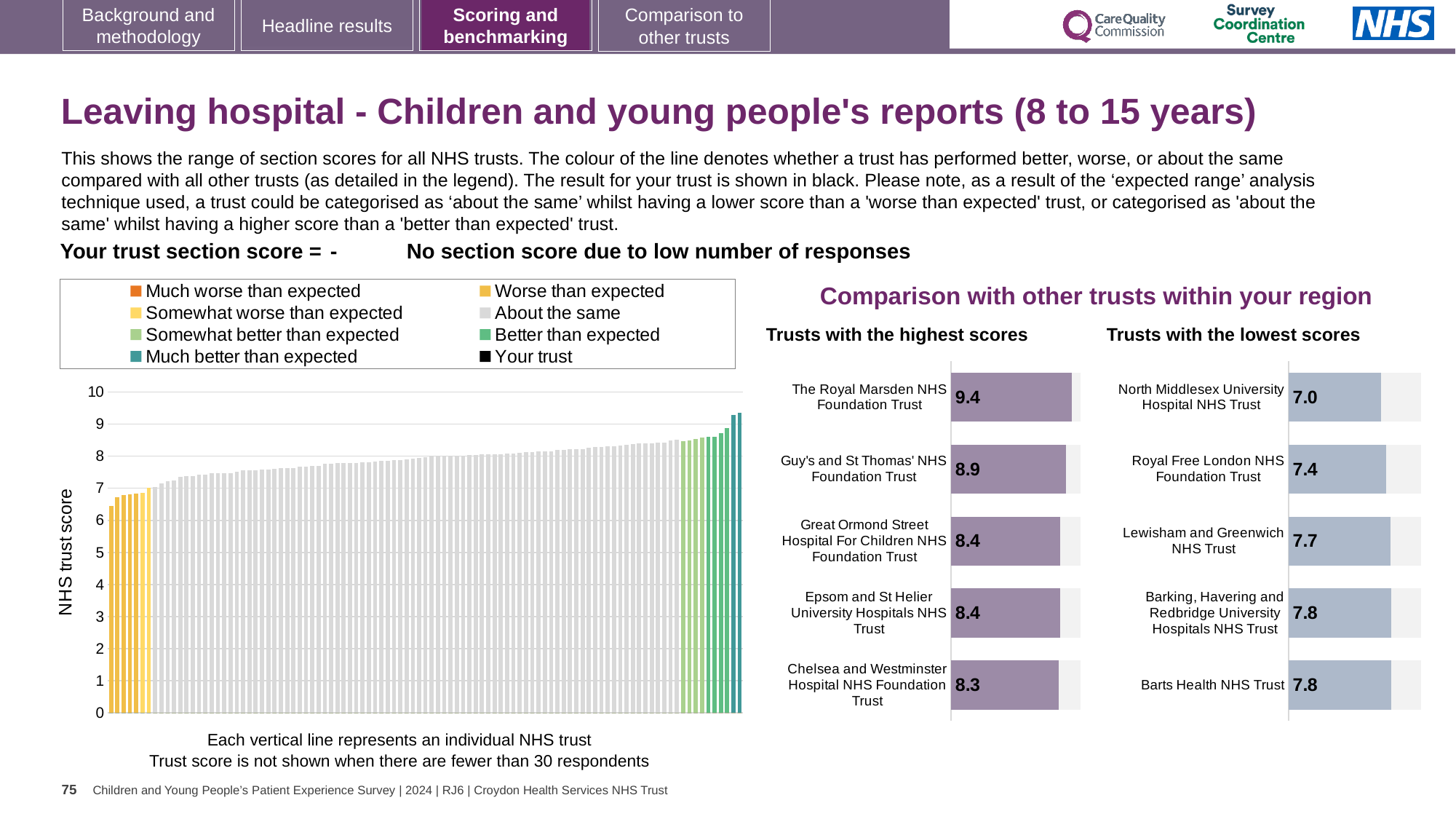
In the 'Trusts with the lowest scores' chart, which trust has the lowest score? North Middlesex University Hospital NHS Trust In the 'Trusts with the lowest scores' chart, what is the score for North Middlesex University Hospital NHS Trust? 7.0 In the 'Trusts with the lowest scores' chart, what is the difference between the scores of Barts Health NHS Trust and North Middlesex University Hospital NHS Trust? 0.8 In the 'Trusts with the highest scores' chart, which trust has the highest score? The Royal Marsden NHS Foundation Trust How many trusts are shown in the 'Trusts with the highest scores' chart? 5 In the 'Trusts with the highest scores' chart, what is the difference between the scores of The Royal Marsden NHS Foundation Trust and Guy's and St Thomas' NHS Foundation Trust? 0.5 In the 'Trusts with the highest scores' chart, what is the score for The Royal Marsden NHS Foundation Trust? 9.4 In the main 'NHS trust score' chart, do the bars rise or fall from left to right? Rise In the 'Trusts with the highest scores' chart, what is the score for Chelsea and Westminster Hospital NHS Foundation Trust? 8.3 How many entries does the legend of the main 'NHS trust score' chart list? 8 In the 'Trusts with the lowest scores' chart, which has the higher score: Royal Free London NHS Foundation Trust or Lewisham and Greenwich NHS Trust? Lewisham and Greenwich NHS Trust What kind of chart is the main chart with the 'NHS trust score' axis? Bar chart